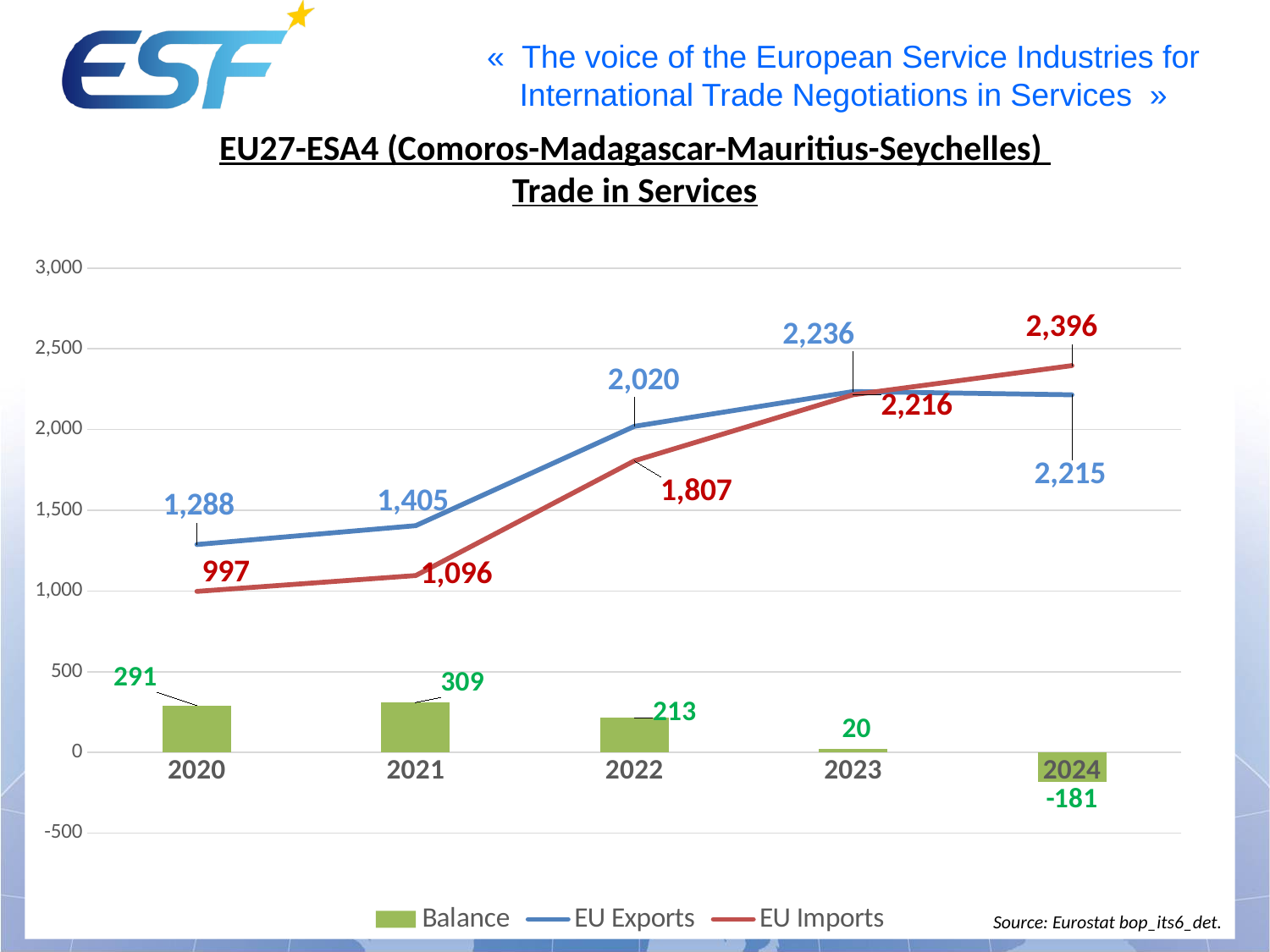
Which series is shown as bars rather than lines? Balance In which year are EU Exports highest? 2023 What is the value of EU Imports in 2024? 2,396 Which is larger in 2024, EU Exports or EU Imports? EU Imports What is the value of EU Exports in 2020? 1,288 Do EU Imports rise or fall from 2020 to 2024? rise What is the source cited for the chart? Eurostat bop_its6_det. What is the difference between EU Exports and EU Imports in 2021? 309 In which year is the Balance lowest? 2024 How many series does the legend list? 3 What is the Balance value for 2022? 213 How many years are shown on the x axis? 5